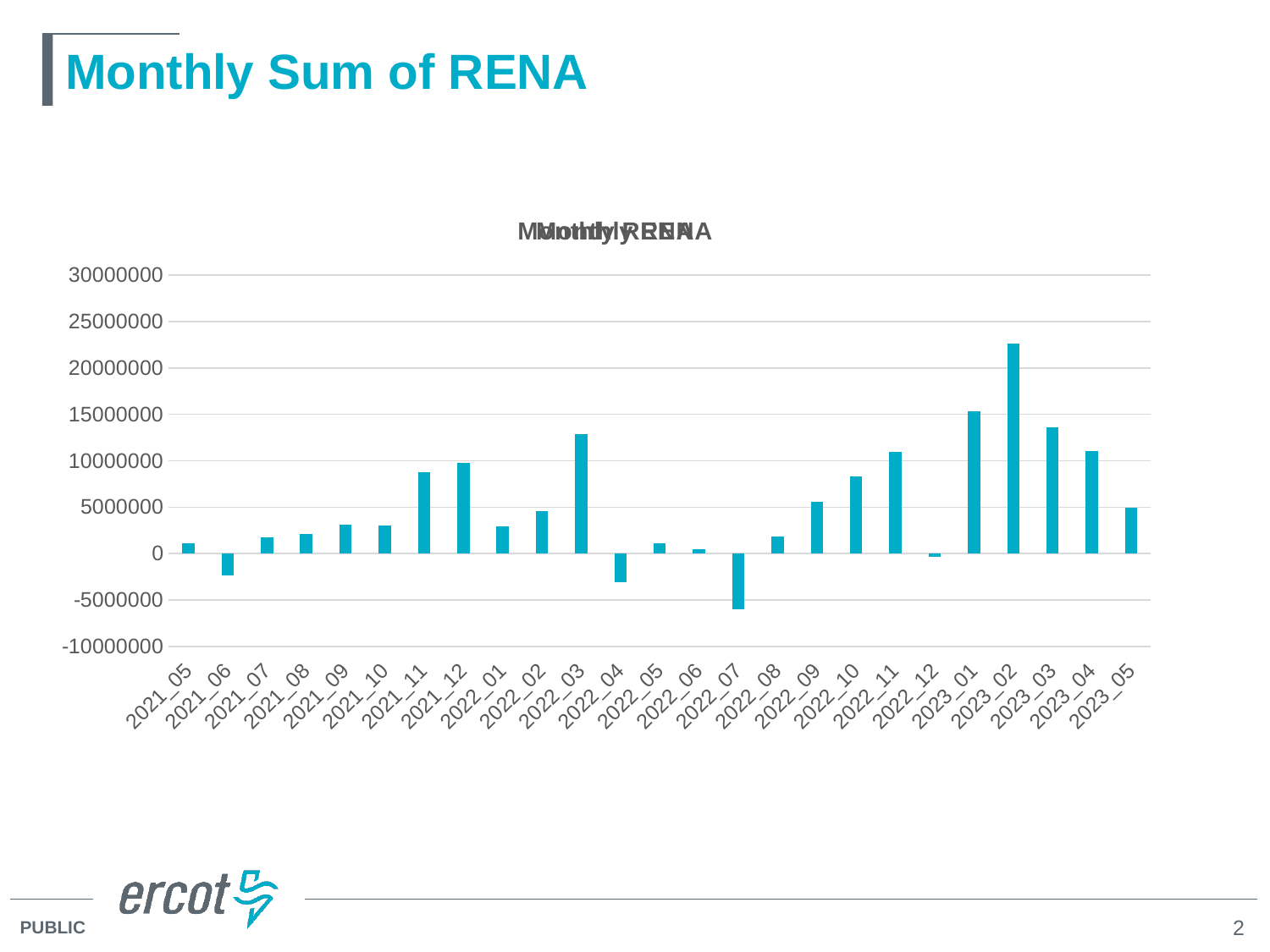
Which month has the lowest value? 2022_07 Which is larger, the value for 2023_02 or the value for 2023_03? 2023_02 Is the value for 2022_04 greater or less than 0? less What kind of chart is shown on the slide? bar chart Which month has the highest value? 2023_02 Is the value for 2021_11 greater or less than 5000000? greater Is the value for 2022_07 greater or less than -5000000? less How many months (categories) are plotted on the x axis? 25 Do the values rise or fall from 2023_02 to 2023_05? fall How many months have a negative value? 4